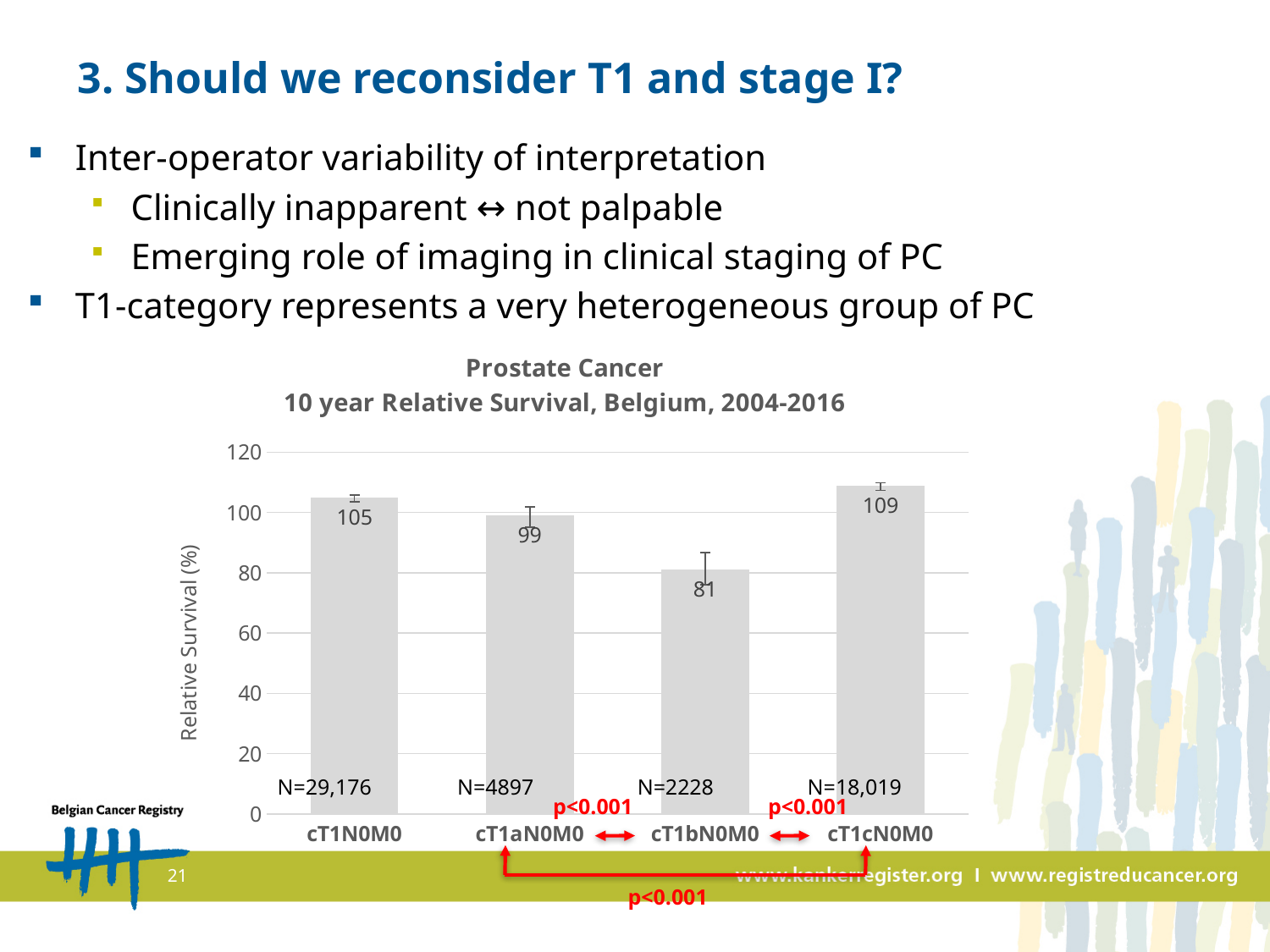
Is the value for cT1bN0M0 greater or less than 100? less What is the 10 year relative survival value for cT1N0M0? 105 What is the difference in relative survival between cT1cN0M0 and cT1bN0M0? 28 Which category has the highest relative survival? cT1cN0M0 What is the 10 year relative survival value for cT1aN0M0? 99 Which category has the lowest relative survival? cT1bN0M0 What is the 10 year relative survival value for cT1bN0M0? 81 What is the difference in relative survival between cT1N0M0 and cT1aN0M0? 6 How many categories are shown on the x axis? 4 What kind of chart is shown on the slide? bar chart What is the N value shown for the cT1cN0M0 category? N=18,019 Which has a higher relative survival, cT1aN0M0 or cT1bN0M0? cT1aN0M0